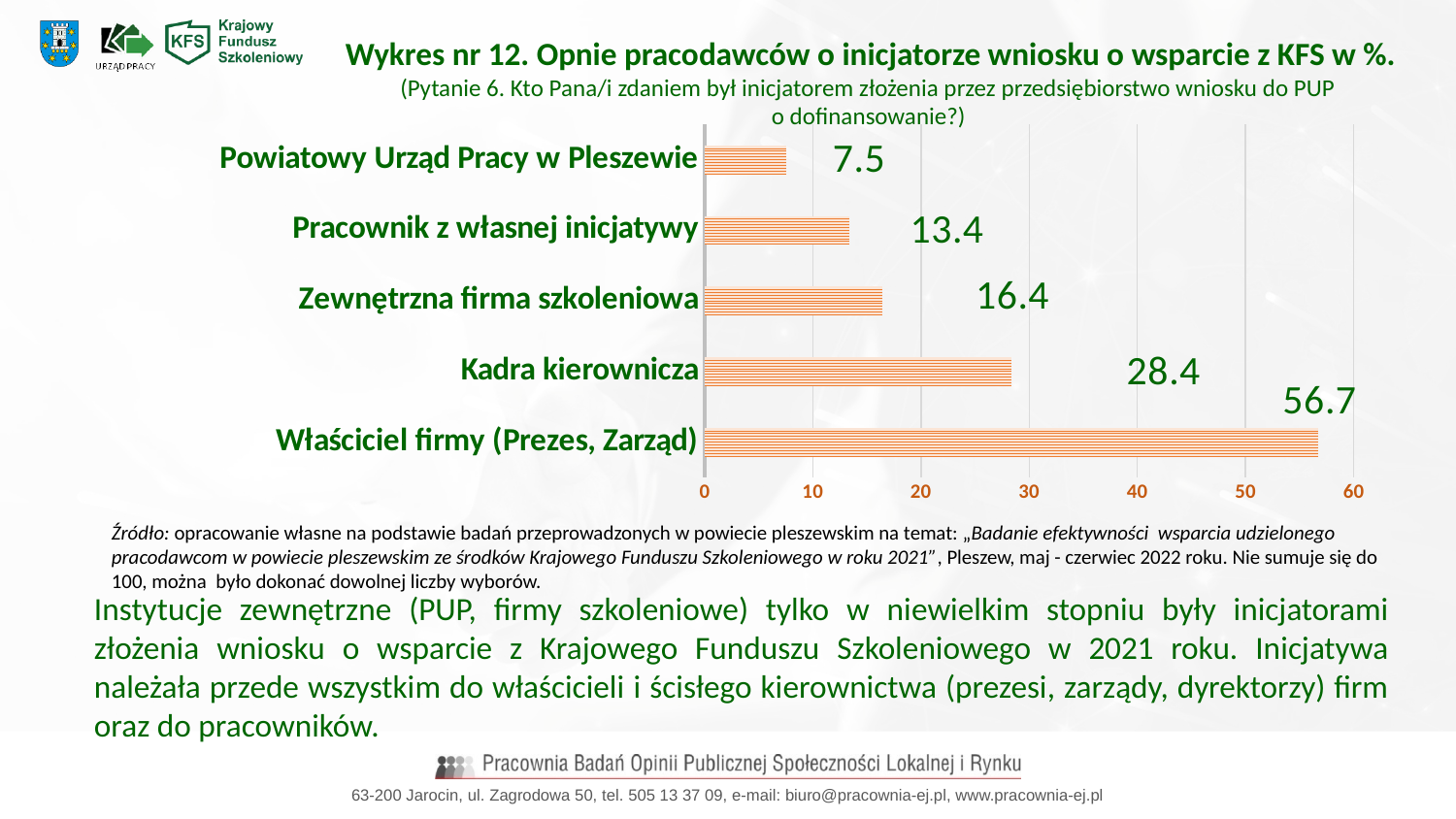
How many categories are shown in the chart? 5 Which category has the lowest value? Powiatowy Urząd Pracy w Pleszewie Which category has the highest value? Właściciel firmy (Prezes, Zarząd) What is the value for Właściciel firmy (Prezes, Zarząd)? 56.7 What is the value for Zewnętrzna firma szkoleniowa? 16.4 Is the value for Kadra kierownicza greater or less than 30? less What kind of chart is shown on the slide? bar chart What is the value for Pracownik z własnej inicjatywy? 13.4 What is the value for Kadra kierownicza? 28.4 Which is larger: the value for Zewnętrzna firma szkoleniowa or Pracownik z własnej inicjatywy? Zewnętrzna firma szkoleniowa What is the difference between the values for Właściciel firmy (Prezes, Zarząd) and Kadra kierownicza? 28.3 What is the value for Powiatowy Urząd Pracy w Pleszewie? 7.5